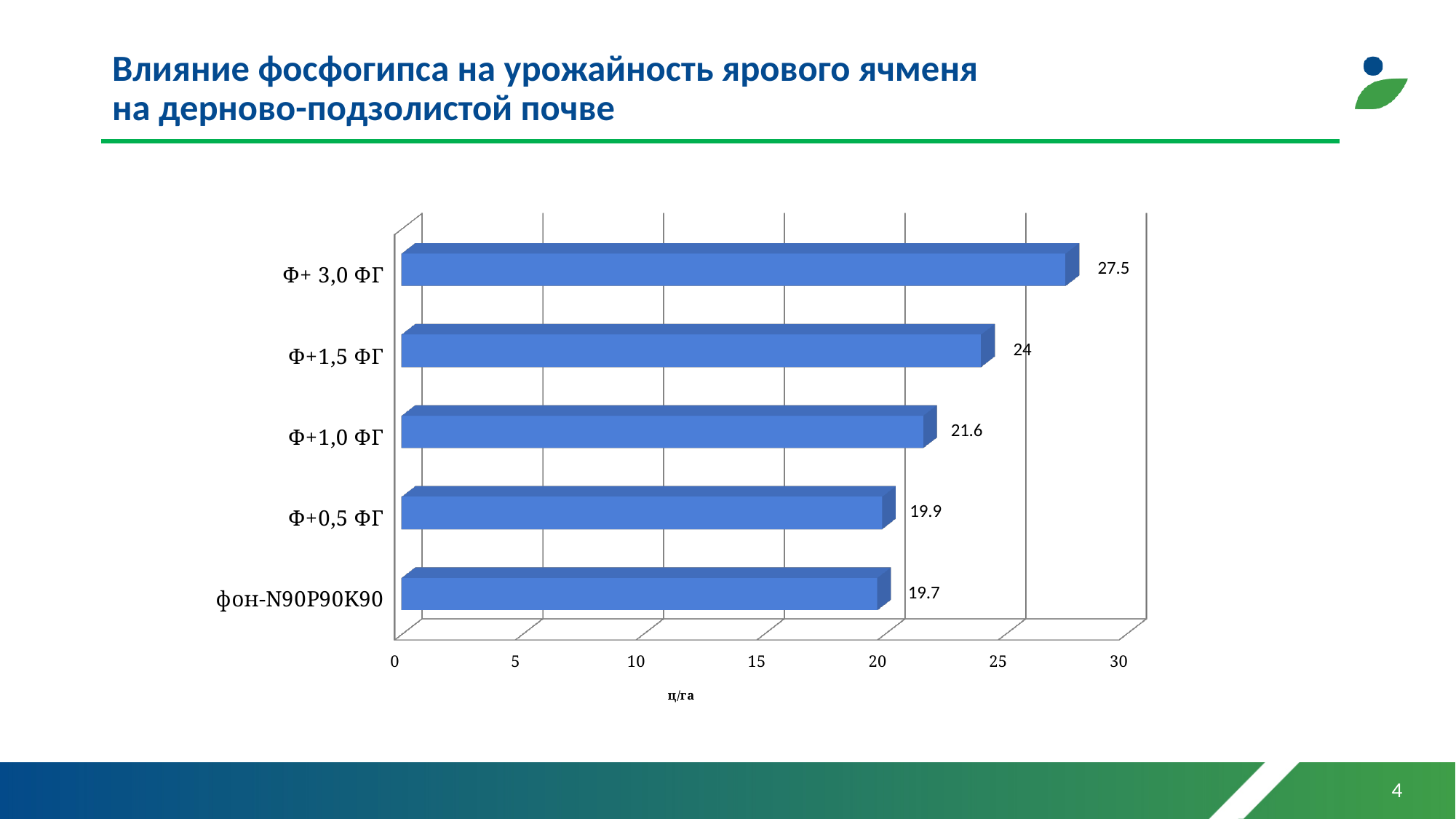
What unit is shown on the horizontal axis of the chart? ц/га What is the value for Ф+1,0 ФГ? 21.6 Is the value for Ф+1,5 ФГ greater or less than 20? greater What is the difference between the values for Ф+ 3,0 ФГ and Ф+1,5 ФГ? 3.5 How many categories are shown in the chart? 5 Which category has the highest value? Ф+ 3,0 ФГ What is the difference between the values for Ф+1,0 ФГ and фон-N90P90K90? 1.9 What is the value for фон-N90P90K90? 19.7 What kind of chart is shown on the slide? bar chart Which is larger, the value for Ф+1,5 ФГ or the value for Ф+0,5 ФГ? Ф+1,5 ФГ Which category has the lowest value? фон-N90P90K90 What is the value for Ф+ 3,0 ФГ? 27.5